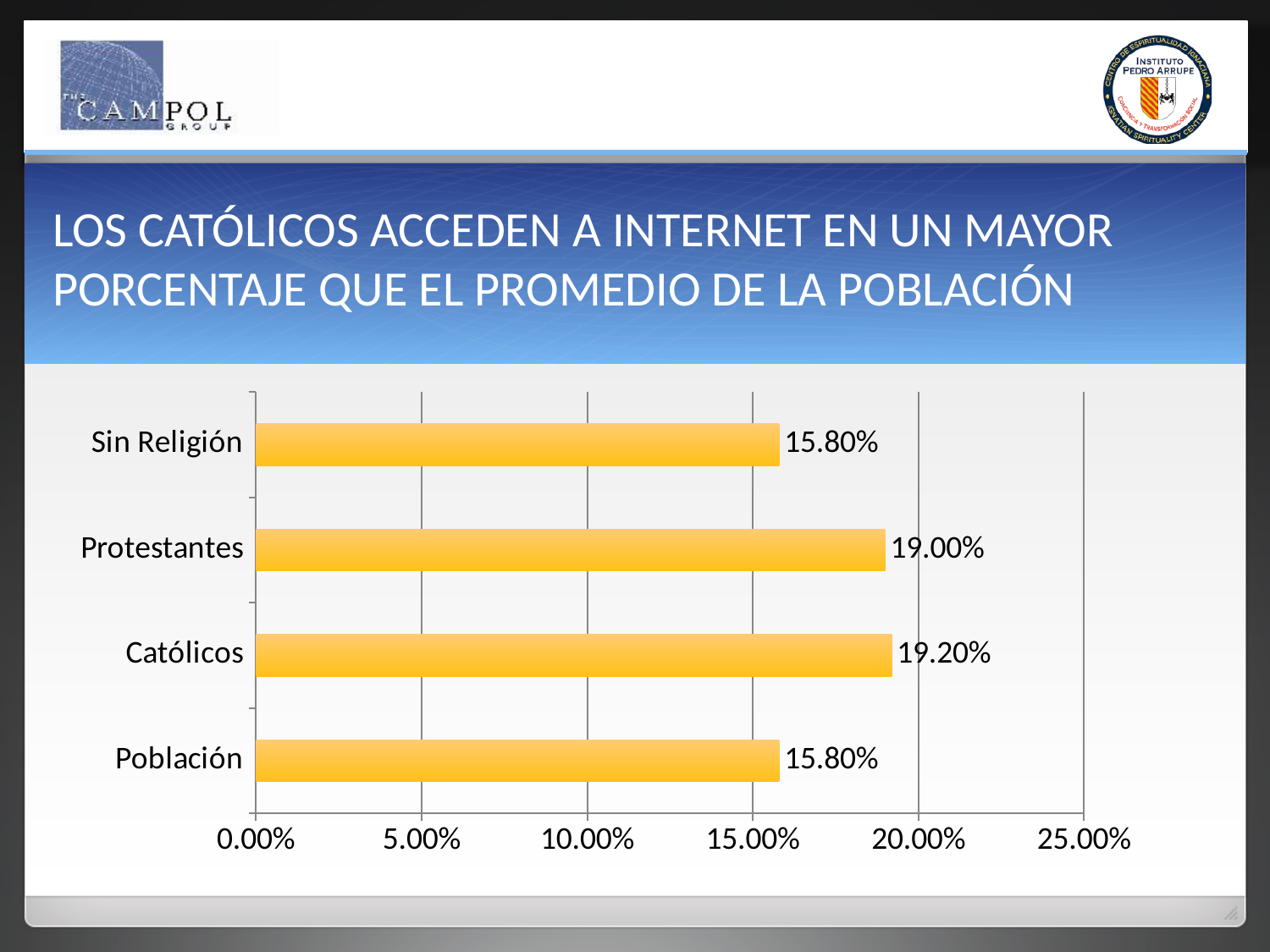
What kind of chart is shown on the slide? Bar chart What is the difference between the values for Católicos and Población? 3.40% What is the highest value shown on the x axis? 25.00% What is the value for Protestantes? 19.00% How many categories are shown in the chart? 4 What is the value for Población? 15.80% Which category has the highest value? Católicos Is the value for Católicos greater or less than 15.00%? greater Which is larger, the value for Protestantes or the value for Población? Protestantes What is the value for Católicos? 19.20% What is the value for Sin Religión? 15.80% What is the difference between the values for Protestantes and Sin Religión? 3.20%